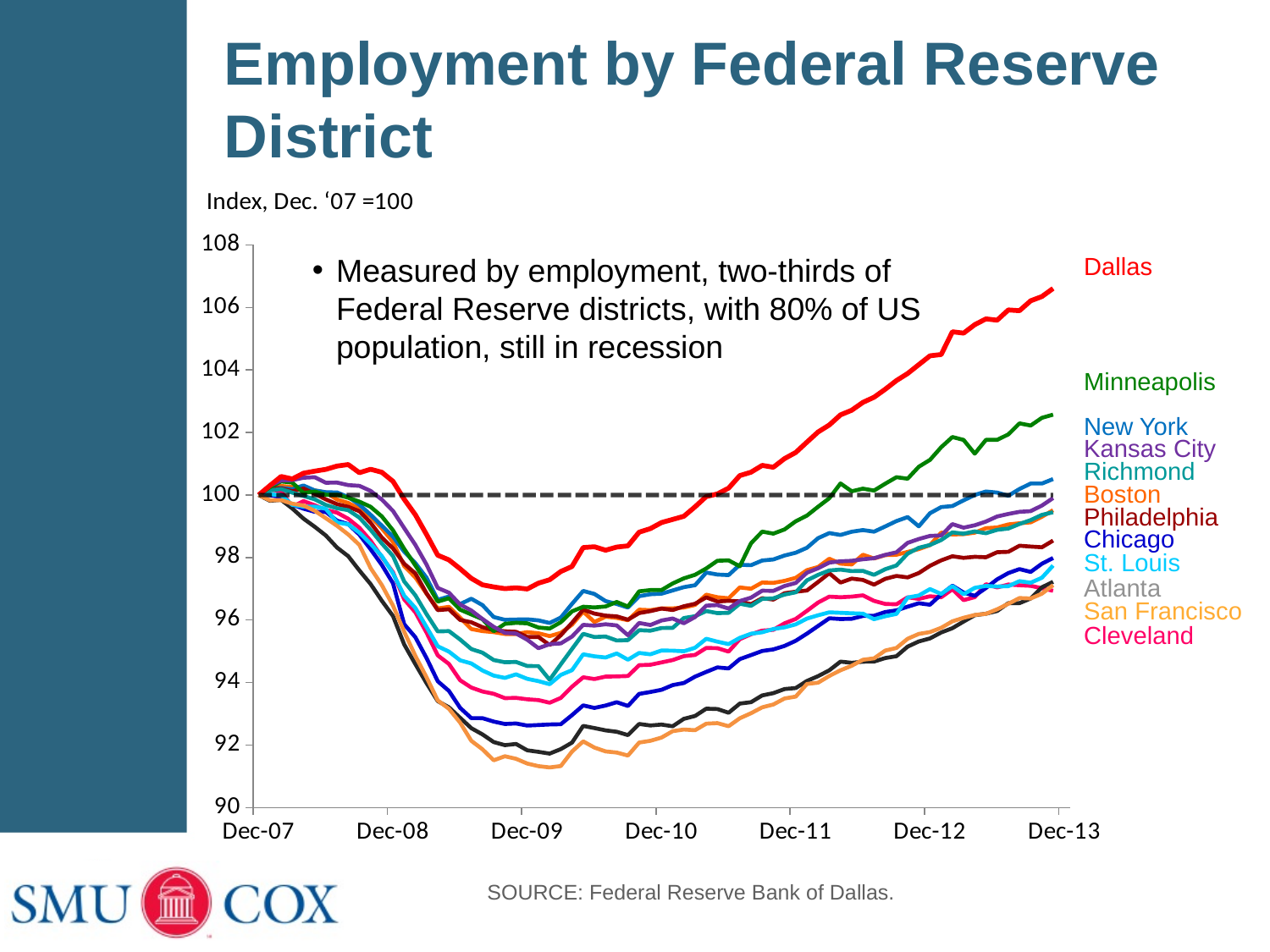
Which district has the highest employment index at Dec-13? Dallas Which is larger at Dec-13, the value for Dallas or the value for Minneapolis? Dallas What is the source cited for the chart? Federal Reserve Bank of Dallas Is the value for Cleveland at Dec-13 greater or less than 98? less How many Federal Reserve districts (series) are labelled on the chart? 12 Do the district lines generally rise or fall between Dec-07 and Dec-09? Fall Is the value for San Francisco at Dec-09 greater or less than 92? less Is the value for Dallas at Dec-13 greater or less than 104? greater What kind of chart is shown on the slide? Line chart What is the base period of the index shown on the chart? Dec. '07 = 100 Does the Dallas line rise or fall between Dec-09 and Dec-13? Rise